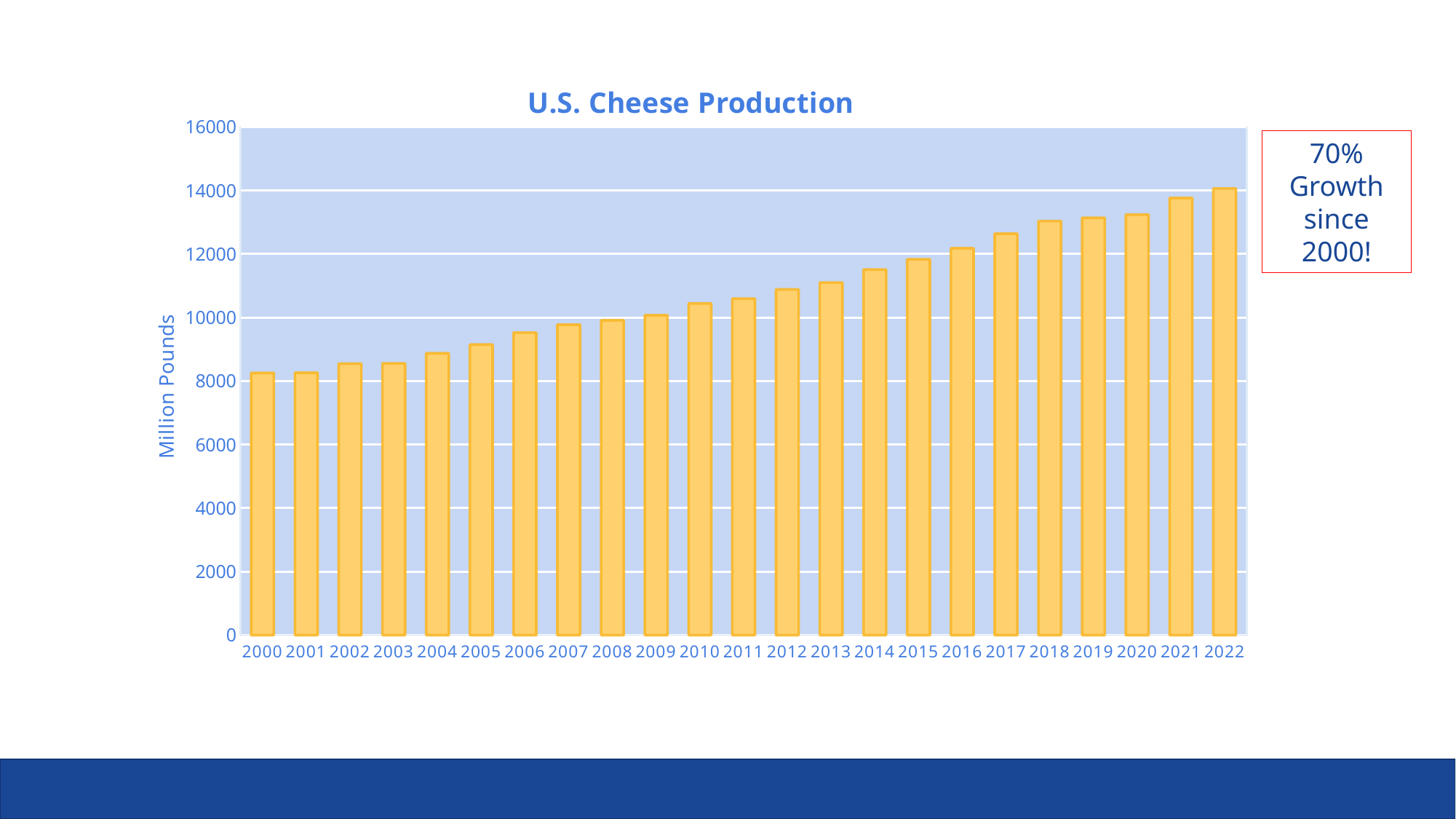
Is the value for 2000 greater or less than 8000? greater How many years are plotted on the chart? 23 Is the value for 2005 greater or less than 10000? less What is the title of the chart? U.S. Cheese Production Which is larger, the value for 2015 or the value for 2005? 2015 Do the values generally rise or fall from 2000 to 2022? Rise Is the value for 2021 greater or less than 14000? less Which year has the highest cheese production on the chart? 2022 What is the label on the vertical axis of the chart? Million Pounds What kind of chart is shown on the slide? Bar chart